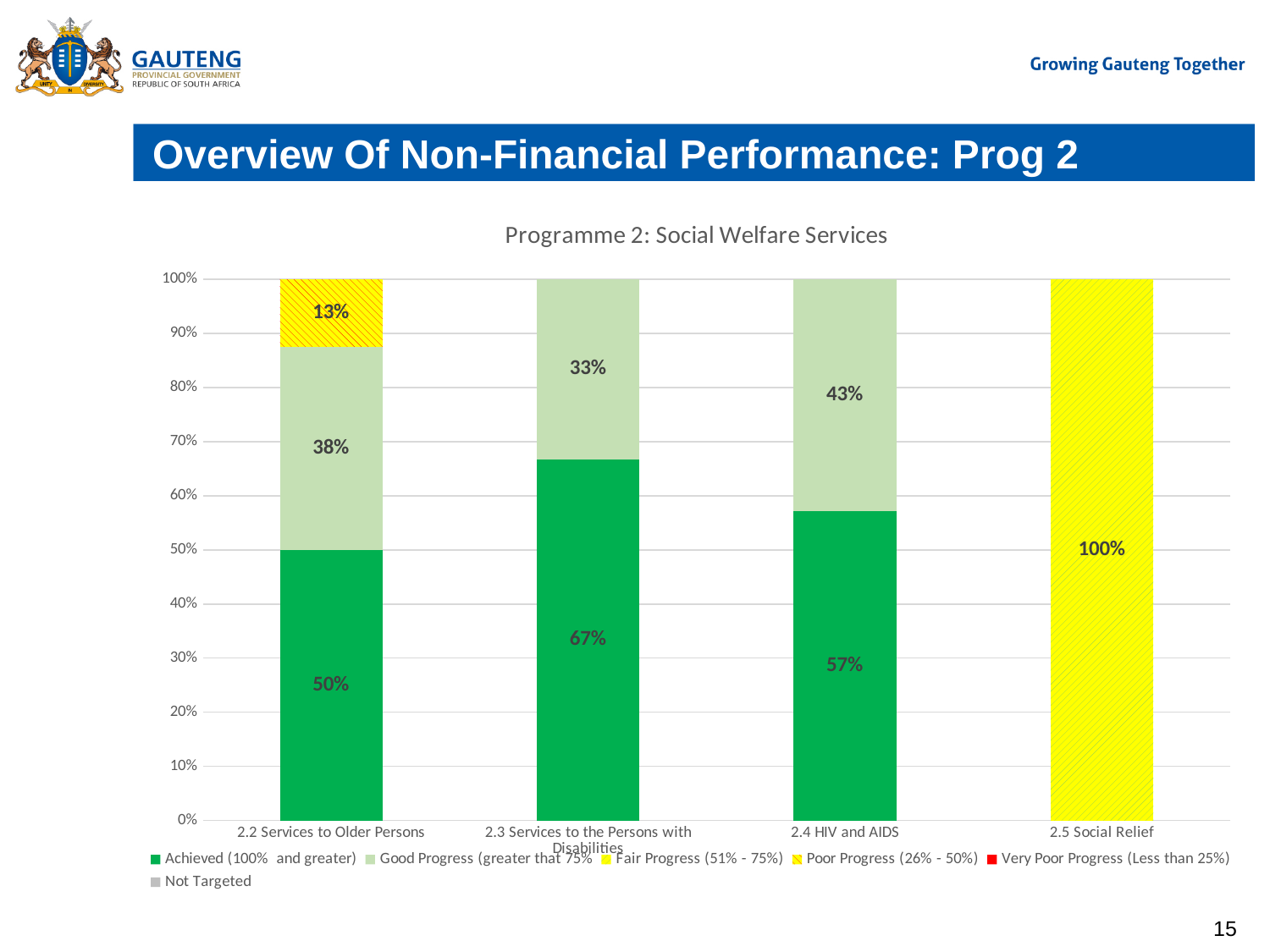
What is the difference between the Achieved values for 2.3 Services to the Persons with Disabilities and 2.4 HIV and AIDS? 10 percentage points What value is labelled on the topmost segment of the 2.2 Services to Older Persons bar? 13% What is the Achieved (100% and greater) value for 2.3 Services to the Persons with Disabilities? 67% Which category has the highest Achieved (100% and greater) value? 2.3 Services to the Persons with Disabilities What kind of chart is shown on the slide? Stacked bar chart How many series does the chart's legend list? 6 What is the title of the chart? Programme 2: Social Welfare Services What is the Good Progress (greater that 75%) value for 2.4 HIV and AIDS? 43% What is the Achieved (100% and greater) value for 2.2 Services to Older Persons? 50% What is the Good Progress (greater that 75%) value for 2.2 Services to Older Persons? 38% How many categories are shown on the x axis of the chart? 4 Which has the larger Good Progress (greater that 75%) value, 2.3 Services to the Persons with Disabilities or 2.4 HIV and AIDS? 2.4 HIV and AIDS